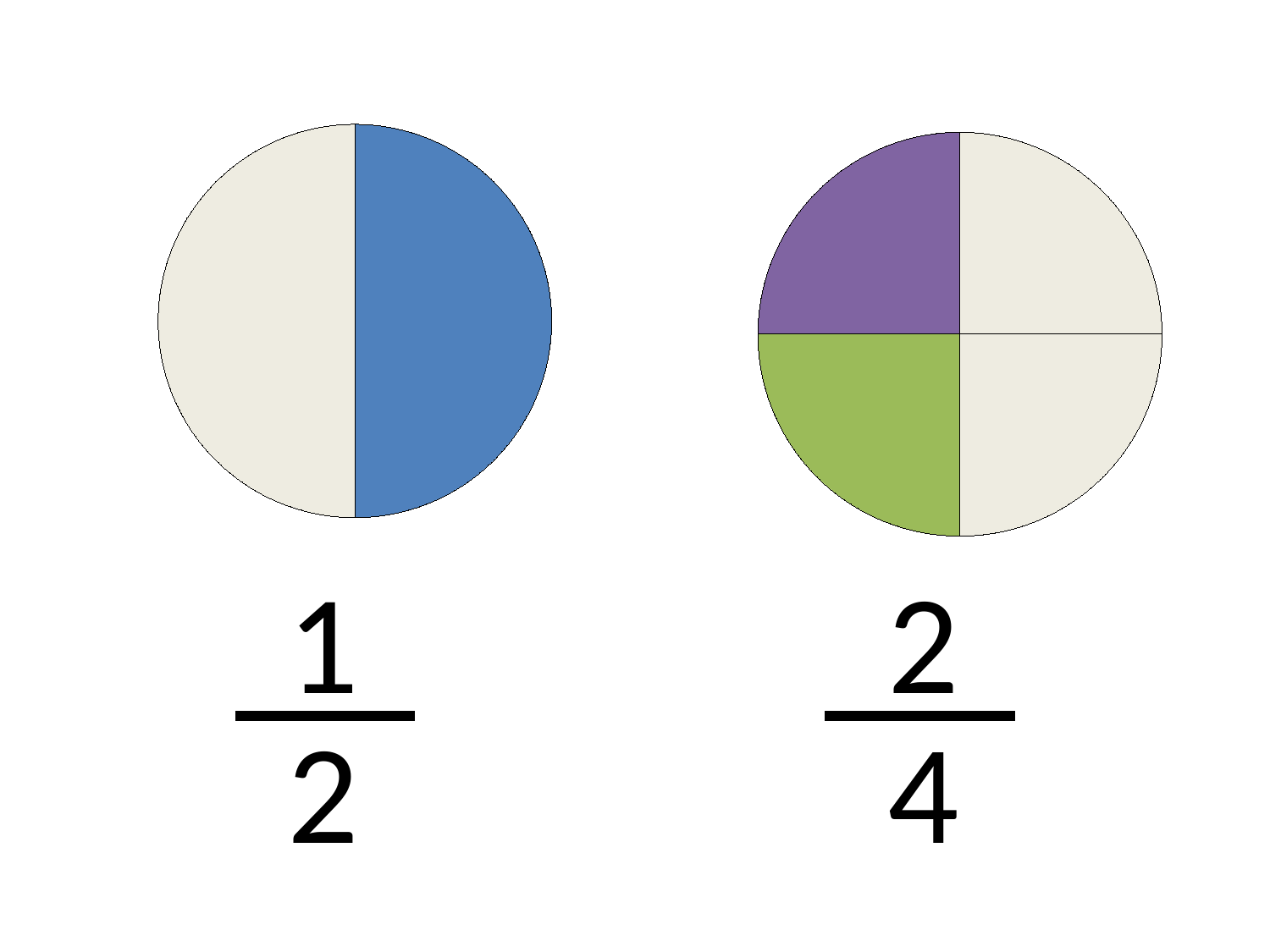
Which pie chart is divided into more slices, the one on the left or the one on the right? the one on the right In the pie chart on the right, how many slices are coloured rather than white? 2 What fraction is printed below the pie chart on the right? 2/4 How many charts are shown on the slide? 2 How many slices does the pie chart on the right have? 4 What kind of chart is the chart on the left of the slide? pie chart In the pie chart on the left, what share of the pie is the blue slice? 1/2 What fraction is printed below the pie chart on the left? 1/2 What kind of chart is the chart on the right of the slide? pie chart In the pie chart on the right, what share of the pie do the purple and green slices make up together? 2/4